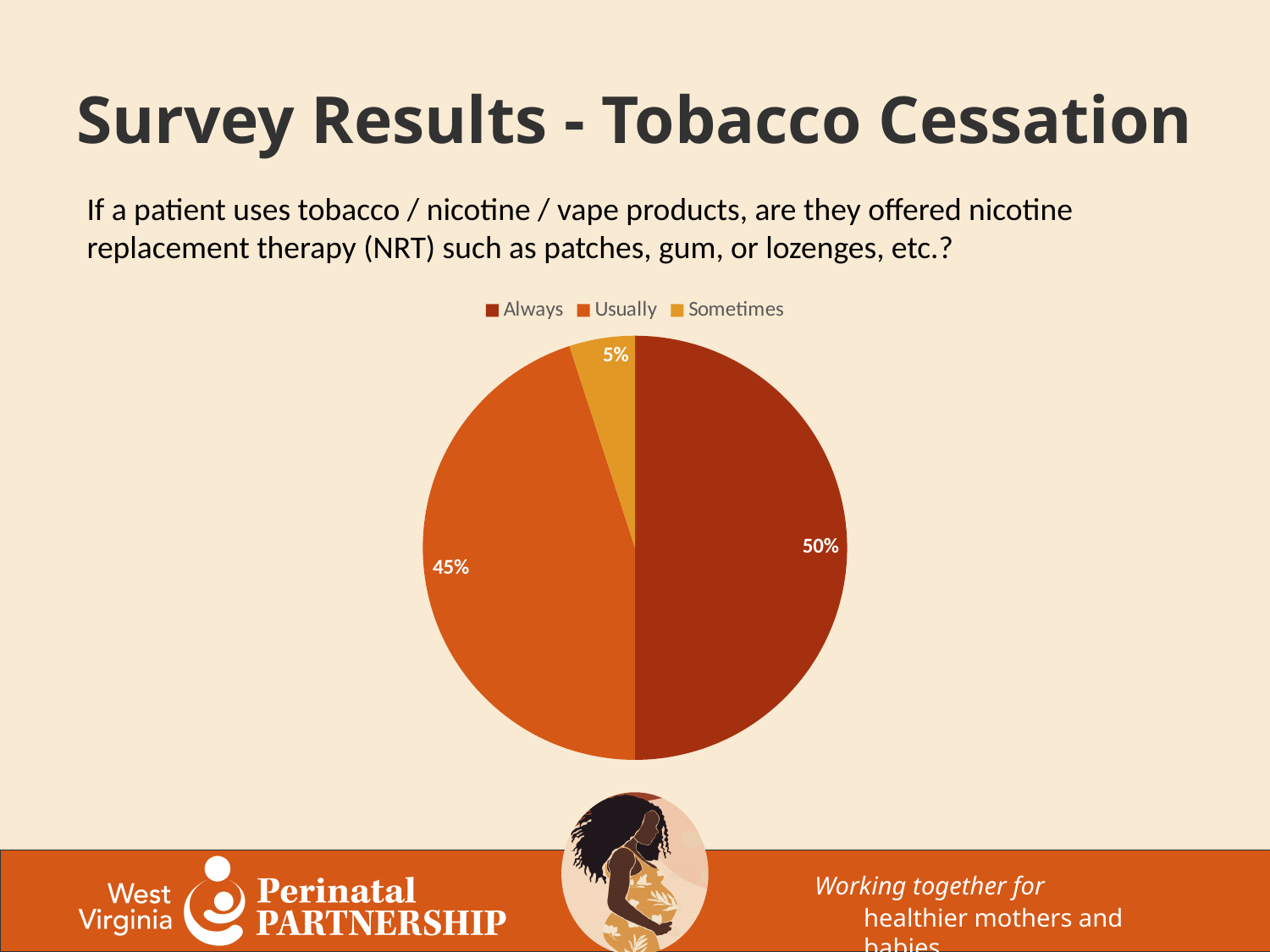
Which slice is larger, Usually or Sometimes? Usually What percentage of the pie is labelled Sometimes? 5% Which category has the smallest slice of the pie? Sometimes What is the combined share of the Always and Usually slices? 95% Which category has the largest slice of the pie? Always What percentage of the pie is labelled Always? 50% How many categories does the legend list? 3 What percentage of the pie is labelled Usually? 45% What kind of chart is shown on the slide? pie chart What is the title of the slide containing the pie chart? Survey Results - Tobacco Cessation What is the difference in percentage points between the Usually and Sometimes slices? 40 What is the difference in percentage points between the Always and Usually slices? 5